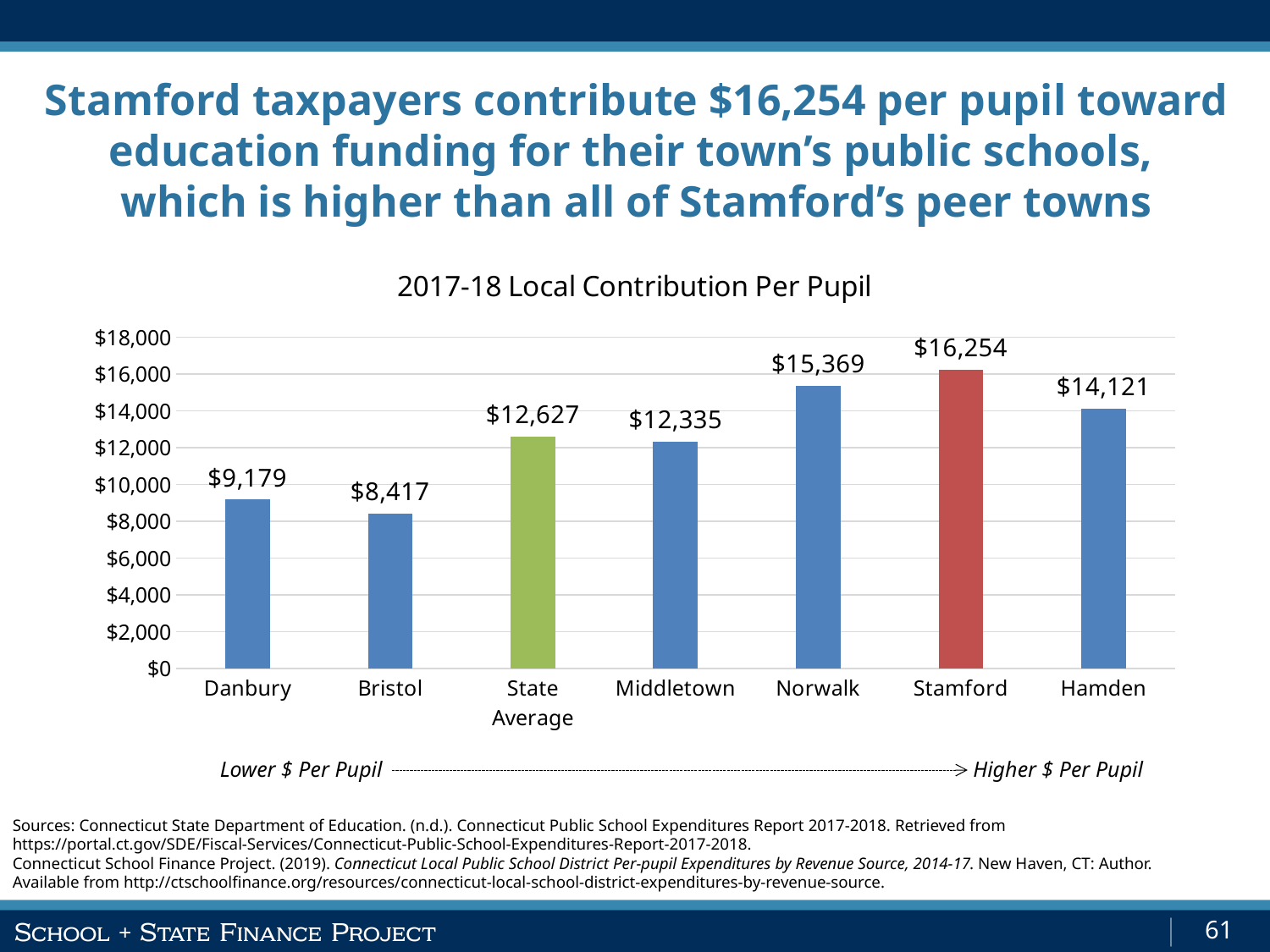
What is the difference between Danbury's and Bristol's local contribution per pupil? $762 Which town has the highest local contribution per pupil? Stamford Which has a higher local contribution per pupil, Hamden or Middletown? Hamden What is the title of the chart? 2017-18 Local Contribution Per Pupil What is the State Average local contribution per pupil shown on the chart? $12,627 How much higher is Stamford's local contribution per pupil than Norwalk's? $885 Is the value for Middletown greater or less than $12,000? greater What is the 2017-18 local contribution per pupil for Stamford? $16,254 What is the local contribution per pupil for Bristol? $8,417 How many bars are shown on the chart? 7 Which town has the lowest local contribution per pupil? Bristol What type of chart is shown on the slide? Bar chart